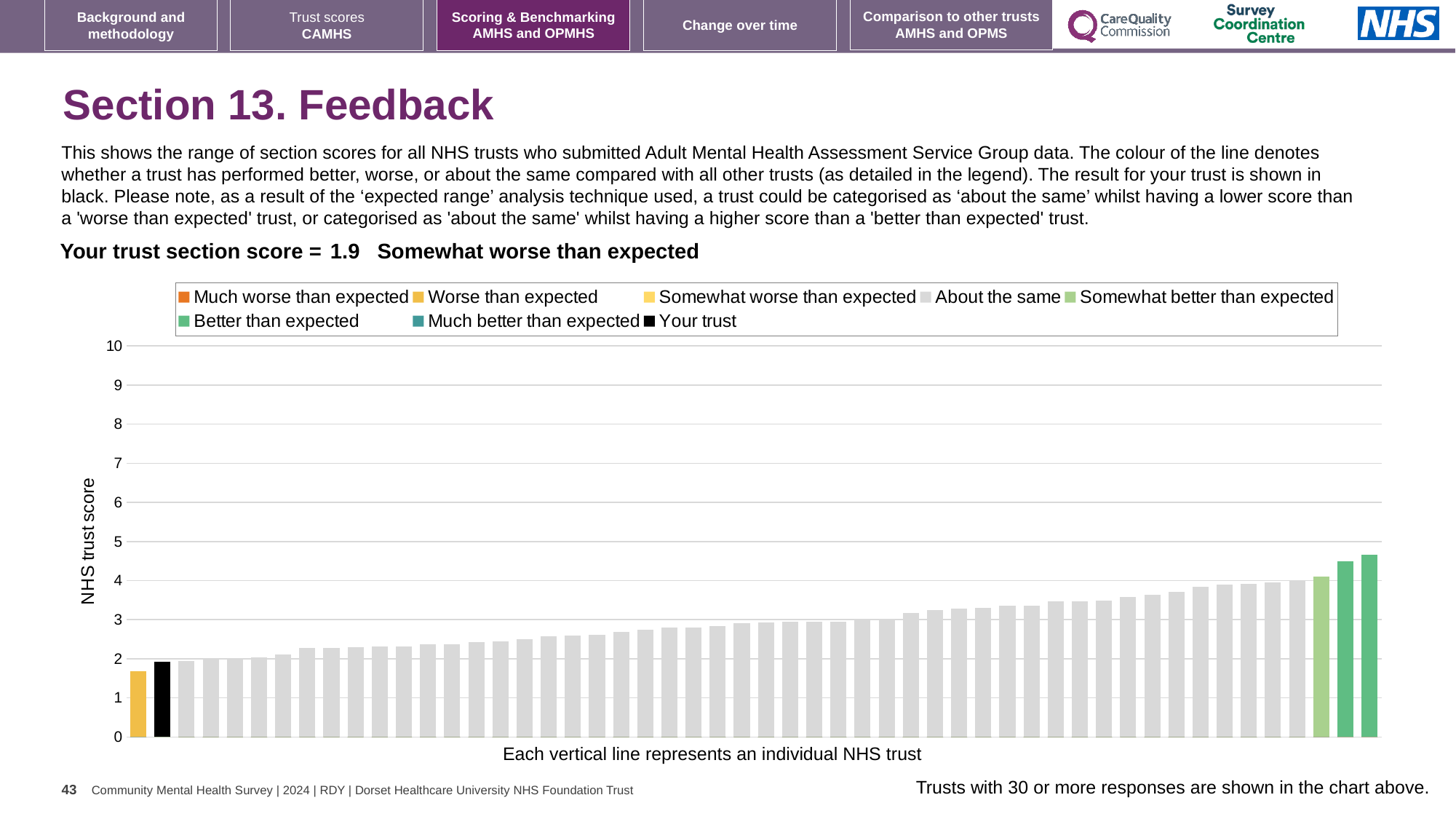
Is the value of the tallest bar greater or less than 5? less How many entries does the chart legend list? 8 What is the section score for your trust? 1.9 What is the label on the y axis of the chart? NHS trust score Which is larger: the value for your trust (black bar) or the value of the rightmost bar? the rightmost bar What is the highest tick value shown on the y axis? 10 Is the value of the tallest bar (rightmost) greater or less than 4? greater Is the value for your trust (black bar) greater or less than 3? less Which category does your trust fall into according to the slide? Somewhat worse than expected What kind of chart is shown on the slide? bar chart Do the bar values rise or fall from left to right along the x axis? rise